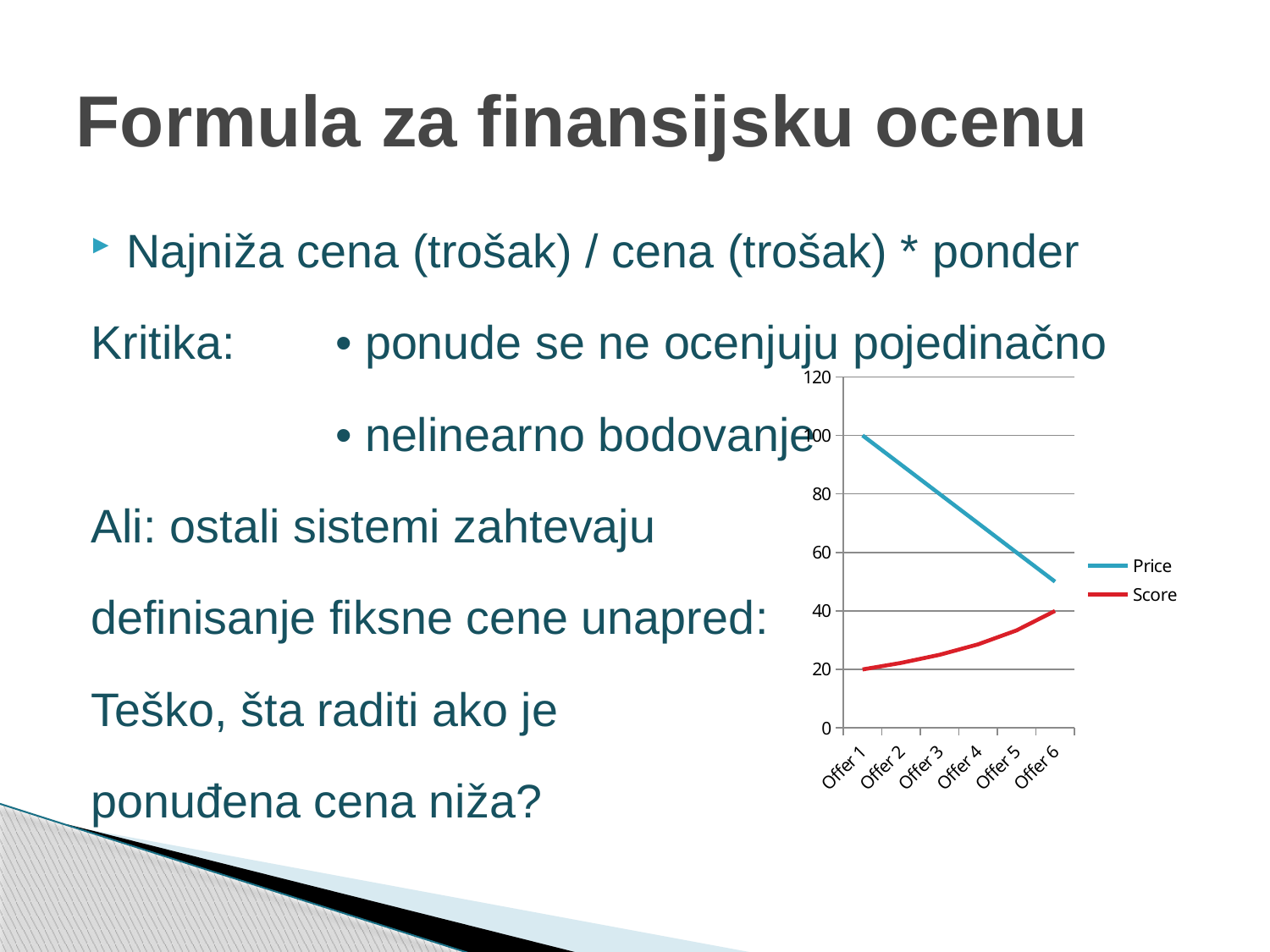
What is the Score value for Offer 1? 20 How many offers are plotted along the x axis of the chart? 6 Is the Price value for Offer 3 greater or less than 60? greater What kind of chart is shown on the slide? line chart For which offer is the Price series highest? Offer 1 Does the Price series rise or fall from Offer 1 to Offer 6? fall What is the Price value for Offer 1? 100 How many series does the chart's legend list? 2 Is the Price value for Offer 6 greater or less than 60? less What is the Score value for Offer 6? 40 Does the Score series rise or fall from Offer 1 to Offer 6? rise Which series is drawn in red in the chart? Score